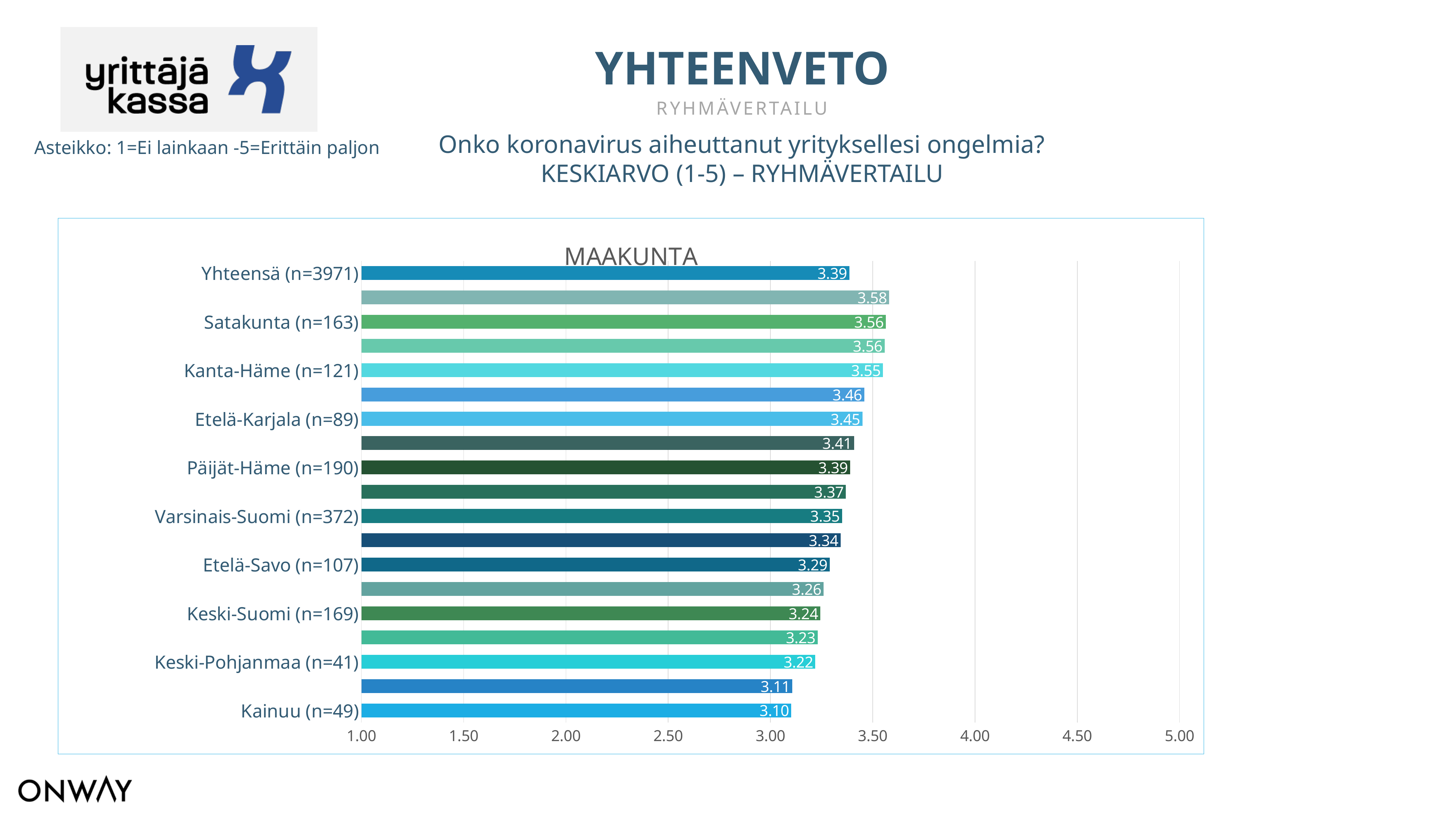
What is the difference between the values for Satakunta (n=163) and Kainuu (n=49)? 0.46 Which labelled category has the lowest value? Kainuu (n=49) What is the title printed above the bars in the chart? MAAKUNTA Which is larger, the value for Etelä-Karjala (n=89) or the value for Etelä-Savo (n=107)? Etelä-Karjala (n=89) What is the value for Varsinais-Suomi (n=372)? 3.35 How many bars are plotted in the chart? 19 What is the highest value shown on any bar in the chart? 3.58 What is the value for Yhteensä (n=3971)? 3.39 What is the value for Kainuu (n=49)? 3.10 Is the value for Keski-Pohjanmaa (n=41) greater or less than 3.50? less What kind of chart is shown on the slide? bar chart What is the value for Satakunta (n=163)? 3.56